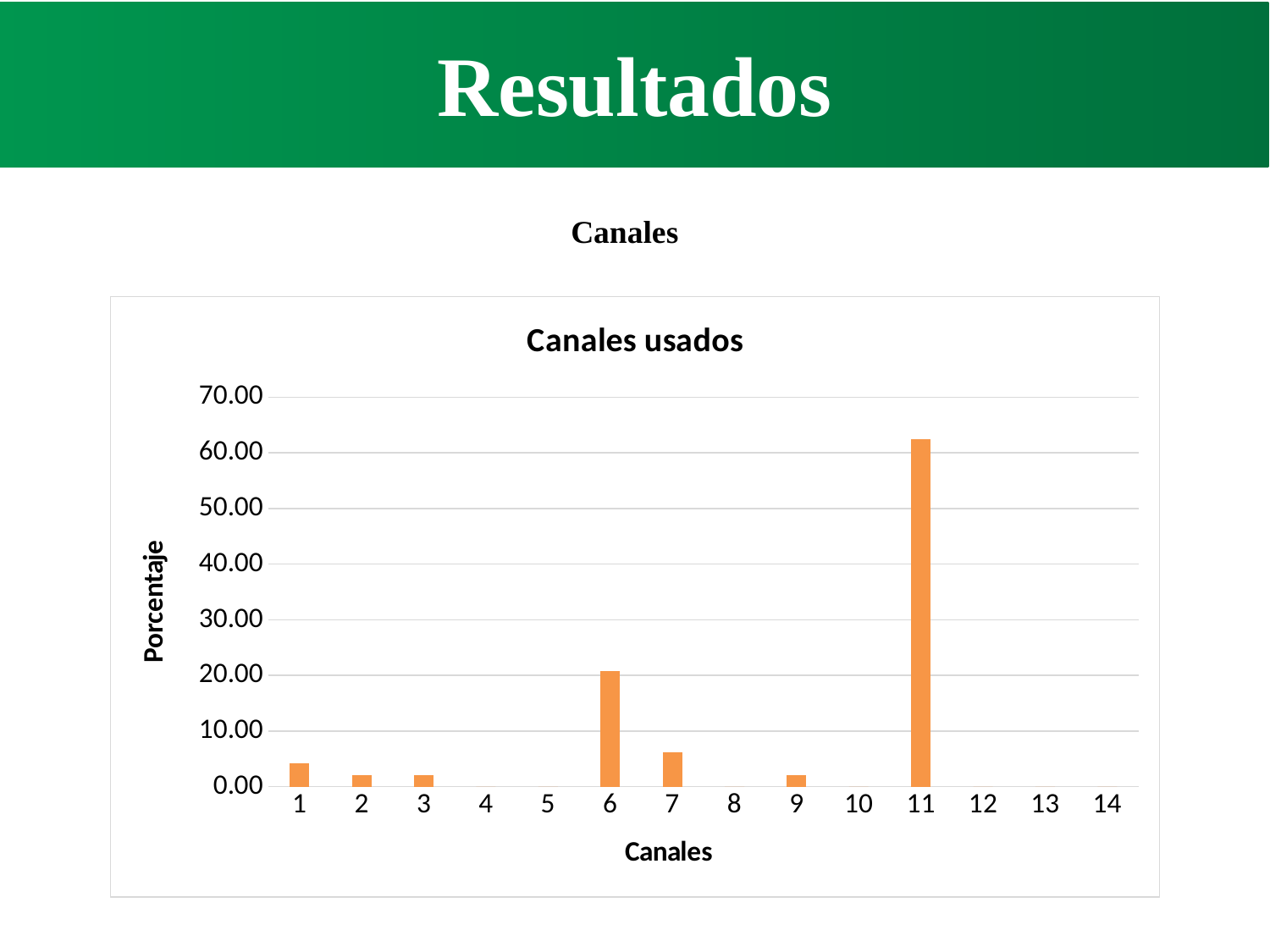
Which has a larger value, channel 6 or channel 7? channel 6 Is the value for channel 6 greater or less than 10.00? greater Which has a larger value, channel 11 or channel 6? channel 11 What is the label of the vertical axis? Porcentaje Which has a larger value, channel 1 or channel 2? channel 1 How many channel categories are shown on the x axis? 14 Is the value for channel 1 greater or less than 10.00? less Is the value for channel 7 greater or less than 10.00? less What kind of chart is shown on the slide? bar chart What is the title of the chart? Canales usados Which channel has the highest percentage? 11